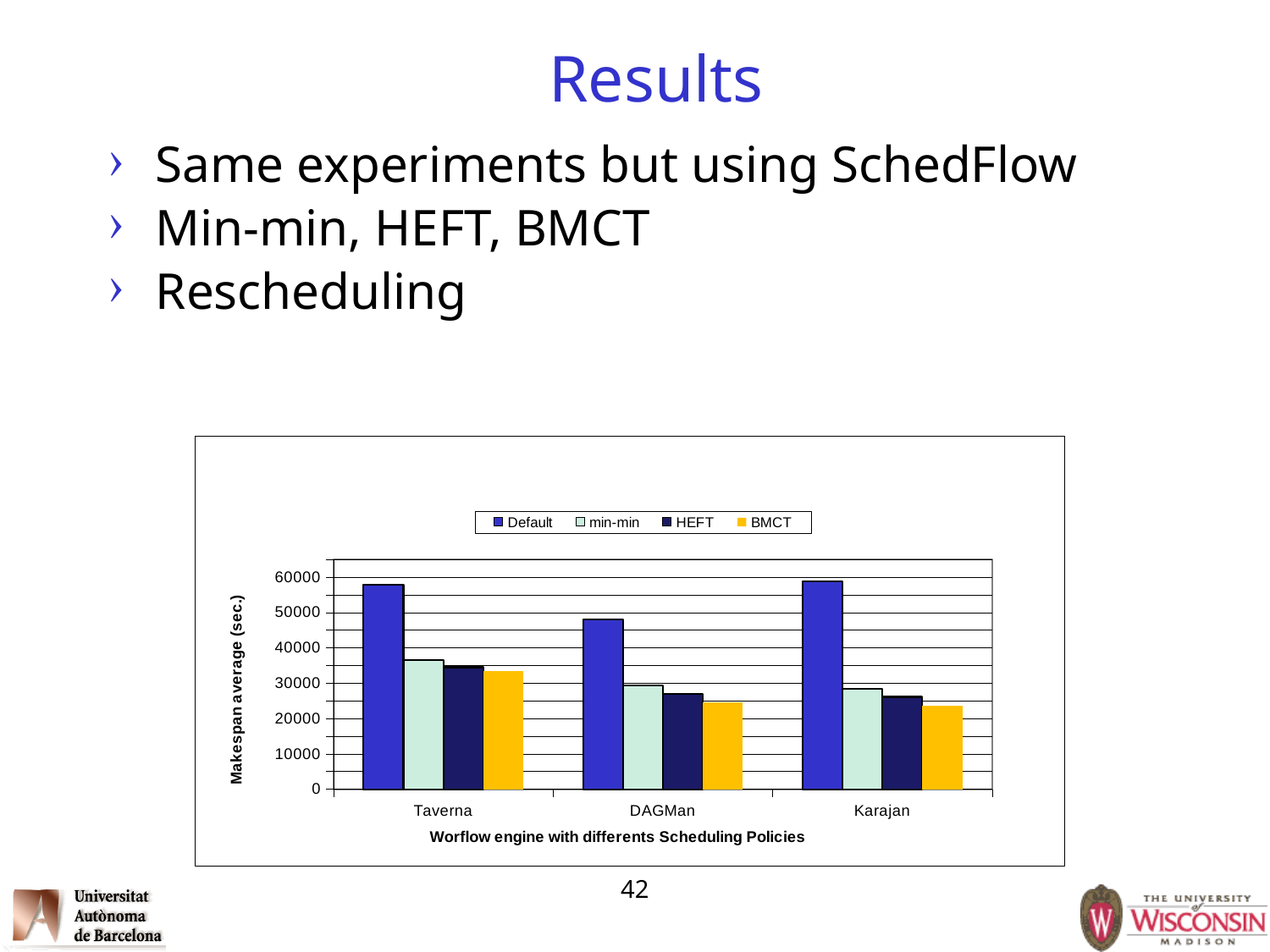
Which is larger, the min-min value for Taverna or the min-min value for DAGMan? Taverna How many series does the legend list? 4 Which workflow engine has the lowest Default makespan? DAGMan How many workflow engines are shown on the x axis? 3 What is the label of the y axis? Makespan average (sec.) Is the Default value for DAGMan greater or less than 50000? less Is the BMCT value for Karajan greater or less than 30000? less Which series is shown in yellow in the legend? BMCT Is the Default value for Taverna greater or less than 50000? greater Which workflow engine has the highest BMCT makespan? Taverna What kind of chart is shown on the slide? bar chart